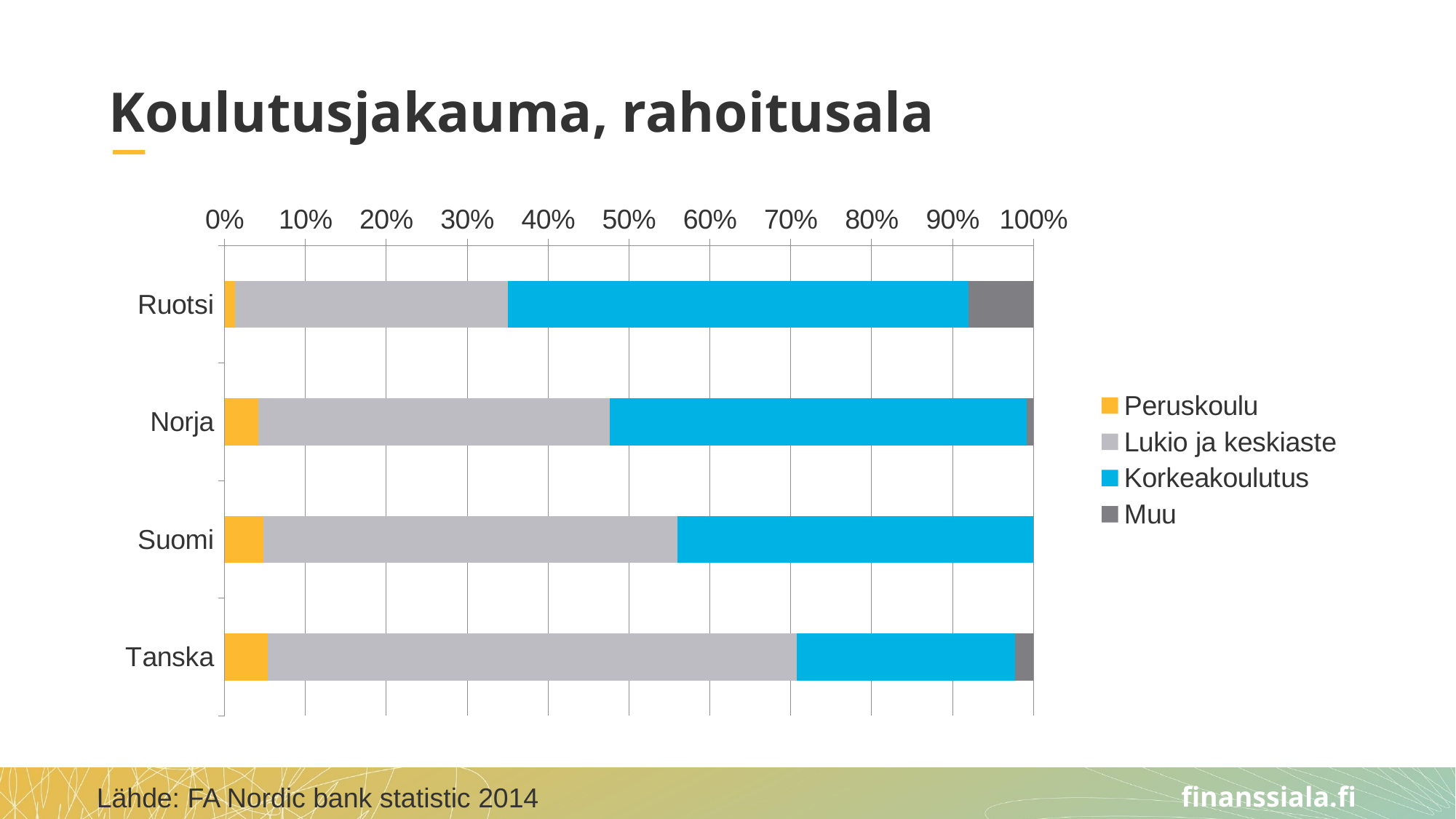
Is the Peruskoulu share for Ruotsi greater or less than 10%? less Which colour represents Korkeakoulutus in the chart? Blue What is the title of the chart slide? Koulutusjakauma, rahoitusala Is the Korkeakoulutus share for Ruotsi larger or smaller than that for Tanska? Larger Which country has the smallest Lukio ja keskiaste share? Ruotsi Which country has the smallest Korkeakoulutus share? Tanska What kind of chart is shown on the slide? Stacked bar chart Which country has the largest Lukio ja keskiaste share? Tanska How many series does the legend list? 4 Is the Lukio ja keskiaste share for Tanska greater or less than 60%? greater Which country has the largest Muu share? Ruotsi How many countries are shown on the chart? 4